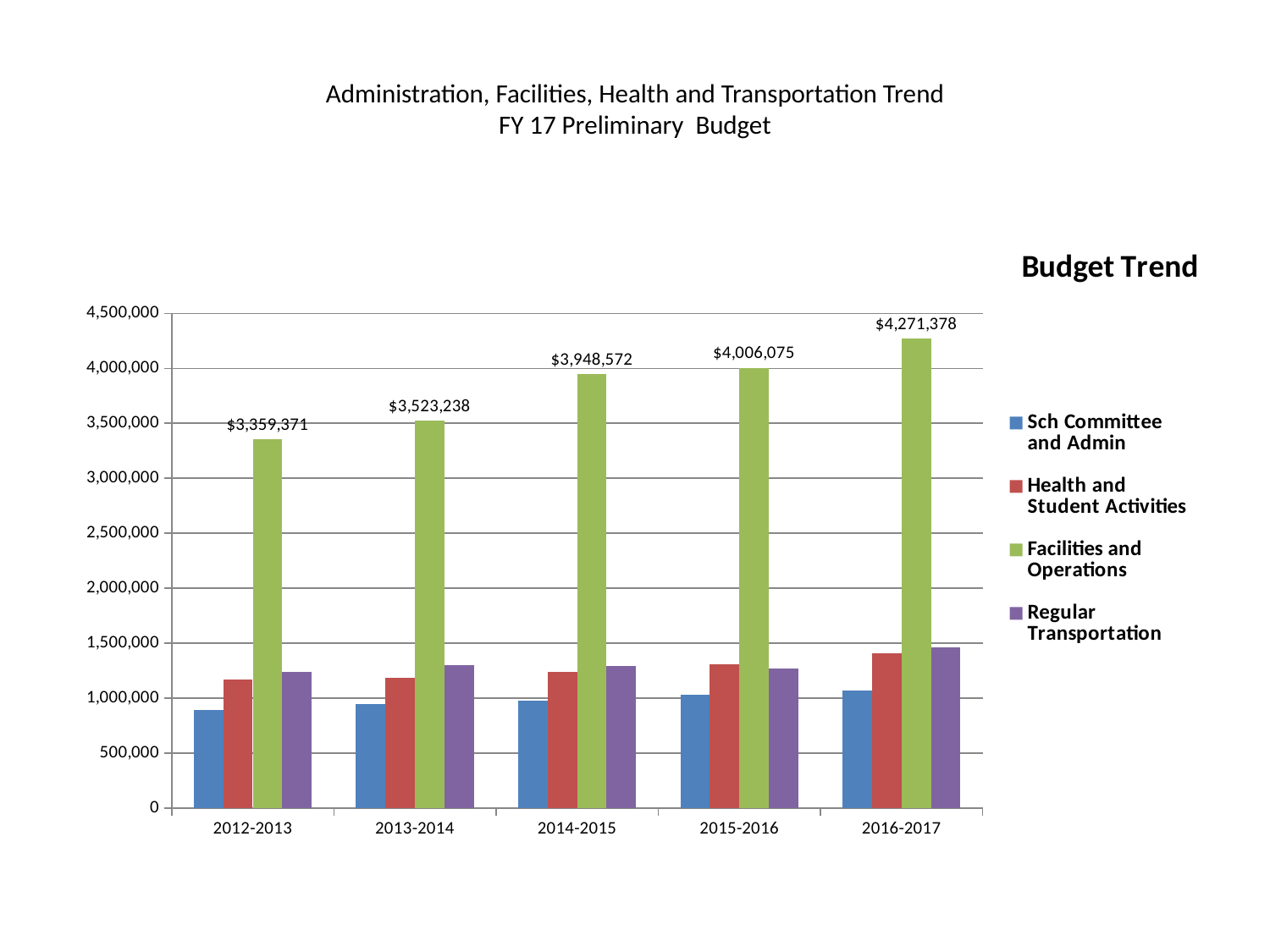
How many years are shown on the x axis? 5 Is the value for Health and Student Activities in 2016-2017 greater or less than 1,000,000? greater In which year is the Facilities and Operations value lowest? 2012-2013 What is the difference between the Facilities and Operations values for 2016-2017 and 2015-2016? $265,303 What is the value for Facilities and Operations in 2012-2013? $3,359,371 What is the value for Facilities and Operations in 2016-2017? $4,271,378 Does the Facilities and Operations value rise or fall from 2012-2013 to 2016-2017? rise Which series has the tallest bar in every year? Facilities and Operations Is the value for Sch Committee and Admin in 2012-2013 greater or less than 1,000,000? less In which year is the Facilities and Operations value highest? 2016-2017 How many series does the legend list? 4 What is the value for Facilities and Operations in 2014-2015? $3,948,572